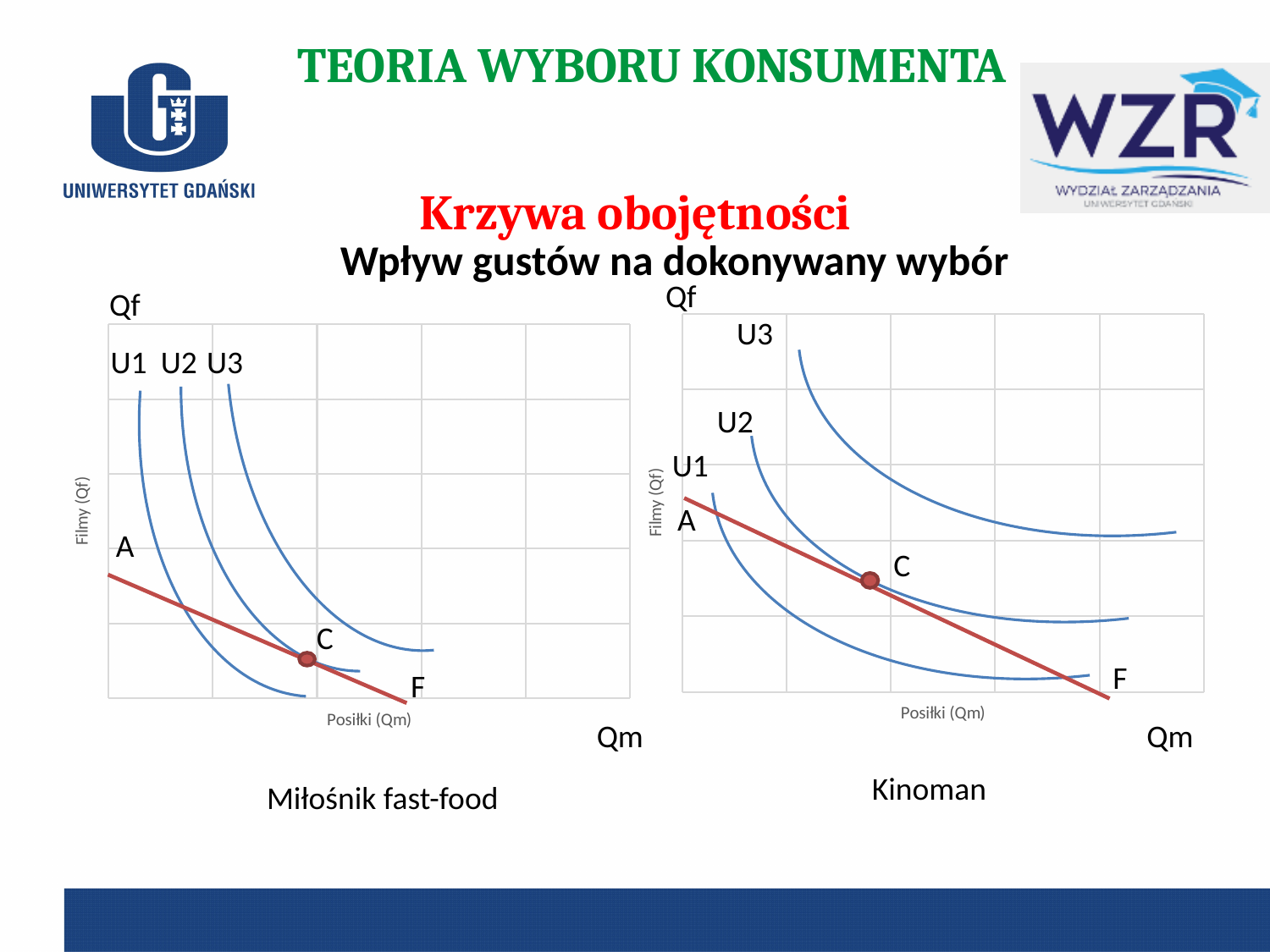
In the left chart (Miłośnik fast-food), do the indifference curves rise or fall as Qm increases along the x axis? fall What kind of chart is the right chart titled "Kinoman"? line chart In the left chart (Miłośnik fast-food), how many indifference curves are drawn? 3 In the right chart (Kinoman), do the indifference curves rise or fall as Qm increases along the x axis? fall What kind of chart is the left chart titled "Miłośnik fast-food"? line chart In the right chart (Kinoman), how many indifference curves are drawn? 3 In the right chart (Kinoman), what is the label of the point where the red budget line touches the indifference curve? C In the left chart (Miłośnik fast-food), what are the labels of the three indifference curves? U1, U2, U3